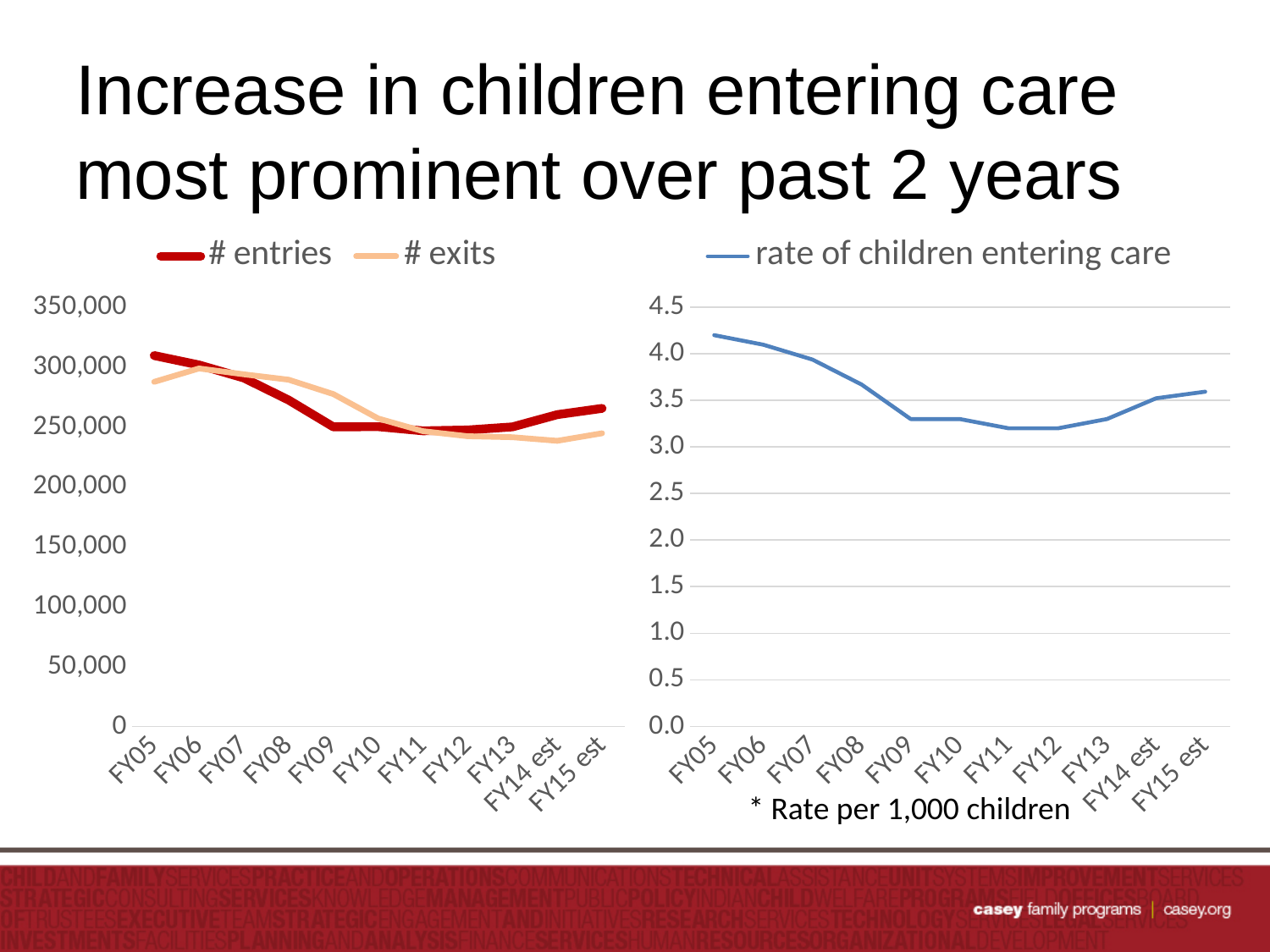
In the left chart, which is larger for FY05: # entries or # exits? # entries In the right chart, is the rate of children entering care for FY05 greater or less than 4.0? greater In the right chart, is the rate of children entering care for FY12 greater or less than 3.5? less In the right chart, which fiscal year has the highest rate of children entering care? FY05 How many fiscal years are plotted on the x axis of the right chart (rate of children entering care)? 11 In the right chart, does the rate of children entering care rise or fall from FY05 to FY09? fall What is the legend label of the series plotted in the right chart? rate of children entering care In the left chart, is the value of # entries for FY09 greater or less than 300,000? less How many series does the legend of the left chart list? 2 In the left chart, which is larger for FY09: # entries or # exits? # exits What kind of chart is the left chart showing # entries and # exits? line chart